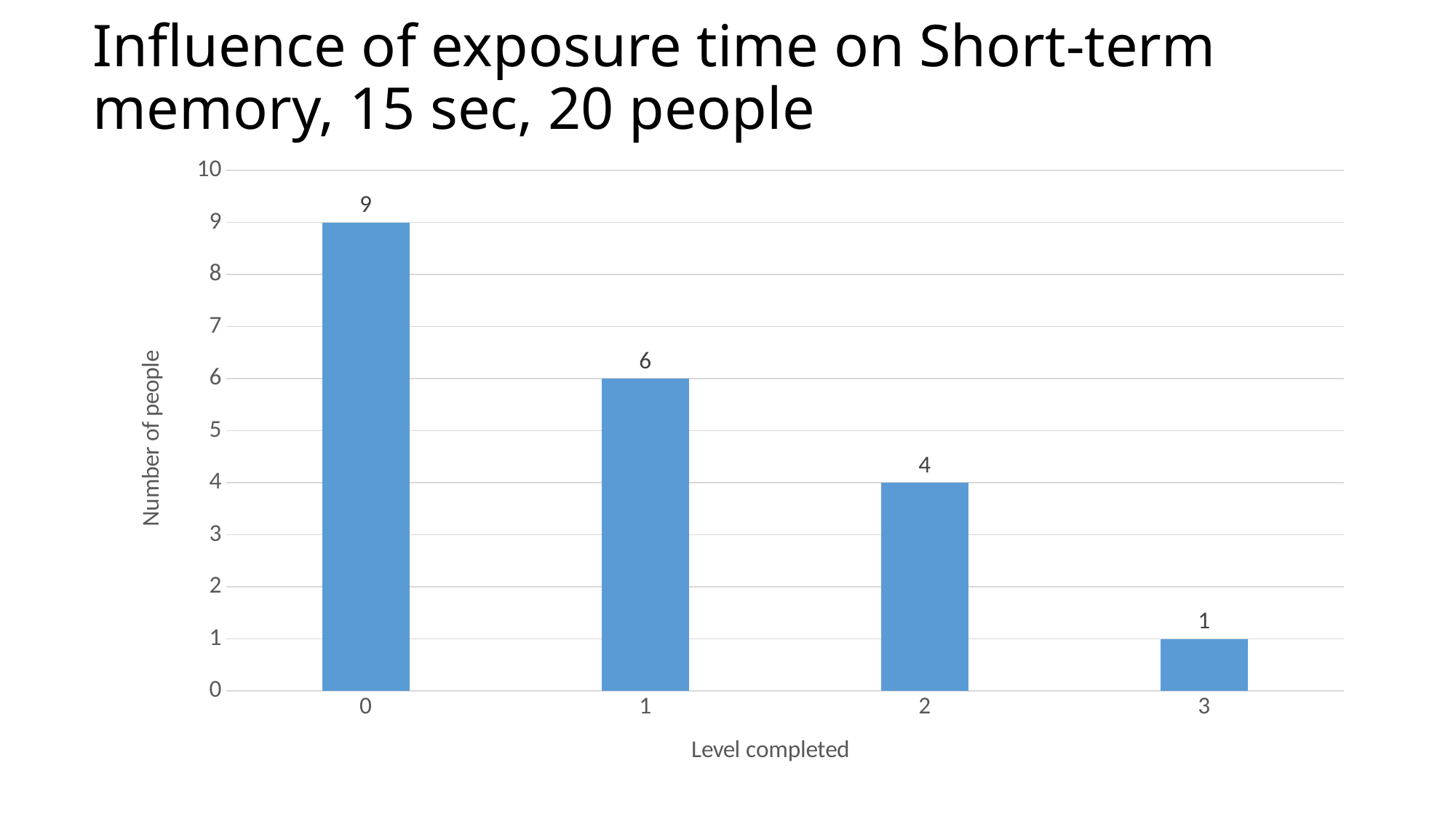
Which has more people: level 2 or level 3? Level 2 What kind of chart is shown on the slide? Bar chart What is the difference in number of people between level 0 and level 1? 3 How many people completed level 2? 4 What is the label of the y axis? Number of people How many people completed level 3? 1 Do the values rise or fall as the level completed increases? Fall How many people completed level 0? 9 Which level completed has the highest number of people? 0 What is the number of people for level completed 1? 6 Which level completed has the lowest number of people? 3 How many levels are shown on the x axis? 4